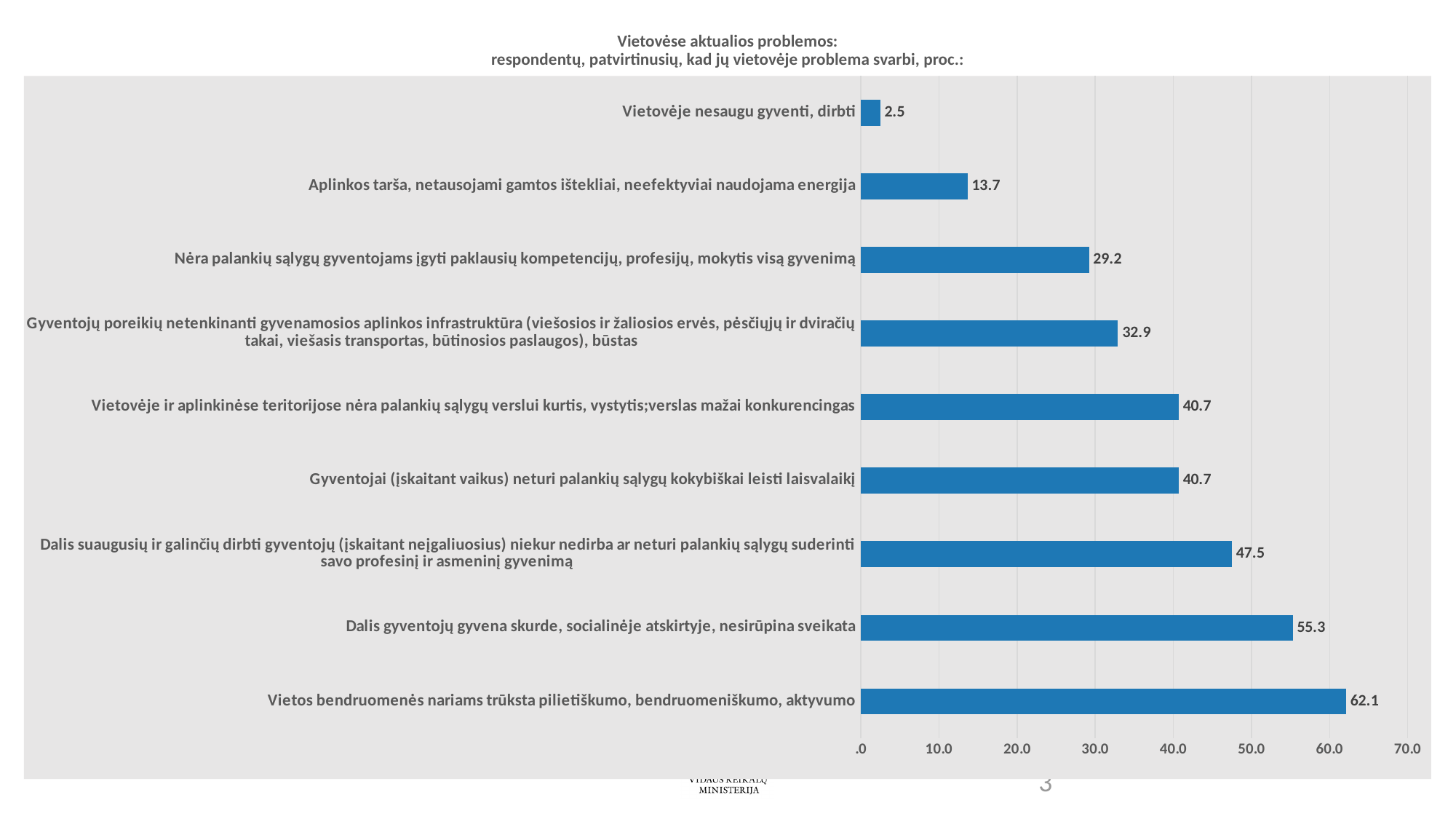
Which category has the lowest value? Vietovėje nesaugu gyventi, dirbti How many categories are shown in the chart? 9 What value is shown for "Aplinkos tarša, netausojami gamtos ištekliai, neefektyviai naudojama energija"? 13.7 What is the maximum value shown on the horizontal axis? 70.0 What value is shown for "Vietos bendruomenės nariams trūksta pilietiškumo, bendruomeniškumo, aktyvumo"? 62.1 Which category has the highest value? Vietos bendruomenės nariams trūksta pilietiškumo, bendruomeniškumo, aktyvumo What kind of chart is shown on the slide? Bar chart Is the value for "Dalis suaugusių ir galinčių dirbti gyventojų (įskaitant neįgaliuosius) niekur nedirba ar neturi palankių sąlygų suderinti savo profesinį ir asmeninį gyvenimą" greater or less than 40.0? greater What value is shown for "Gyventojai (įskaitant vaikus) neturi palankių sąlygų kokybiškai leisti laisvalaikį"? 40.7 What value is shown for "Dalis gyventojų gyvena skurde, socialinėje atskirtyje, nesirūpina sveikata"? 55.3 What is the difference between the values for "Vietos bendruomenės nariams trūksta pilietiškumo, bendruomeniškumo, aktyvumo" and "Dalis gyventojų gyvena skurde, socialinėje atskirtyje, nesirūpina sveikata"? 6.8 Which is larger: the value for "Nėra palankių sąlygų gyventojams įgyti paklausių kompetencijų, profesijų, mokytis visą gyvenimą" or the value for "Aplinkos tarša, netausojami gamtos ištekliai, neefektyviai naudojama energija"? Nėra palankių sąlygų gyventojams įgyti paklausių kompetencijų, profesijų, mokytis visą gyvenimą